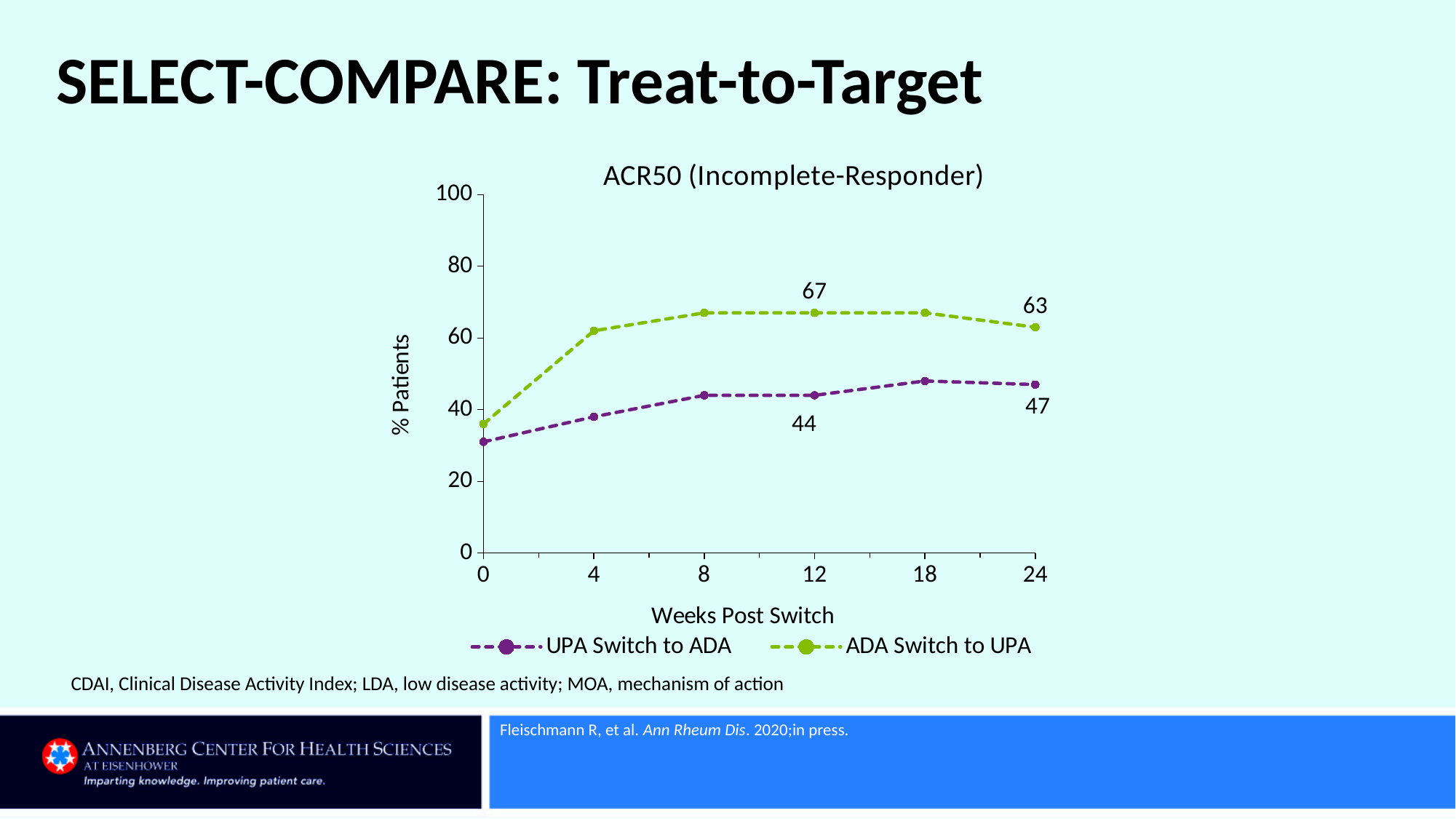
What is the value for ADA Switch to UPA at week 24? 63 Is the value for ADA Switch to UPA at week 0 greater or less than 40? less What is the title of the chart? ACR50 (Incomplete-Responder) How many time points are plotted along the x axis? 6 What kind of chart is shown on the slide? Line chart What is the value for UPA Switch to ADA at week 12? 44 What is the difference between the ADA Switch to UPA and UPA Switch to ADA values at week 12? 23 What is the value for ADA Switch to UPA at week 12? 67 What is the value for UPA Switch to ADA at week 24? 47 How many series does the legend list? 2 Does the UPA Switch to ADA series rise or fall from week 0 to week 18? Rise Which series has the higher value at week 24, UPA Switch to ADA or ADA Switch to UPA? ADA Switch to UPA